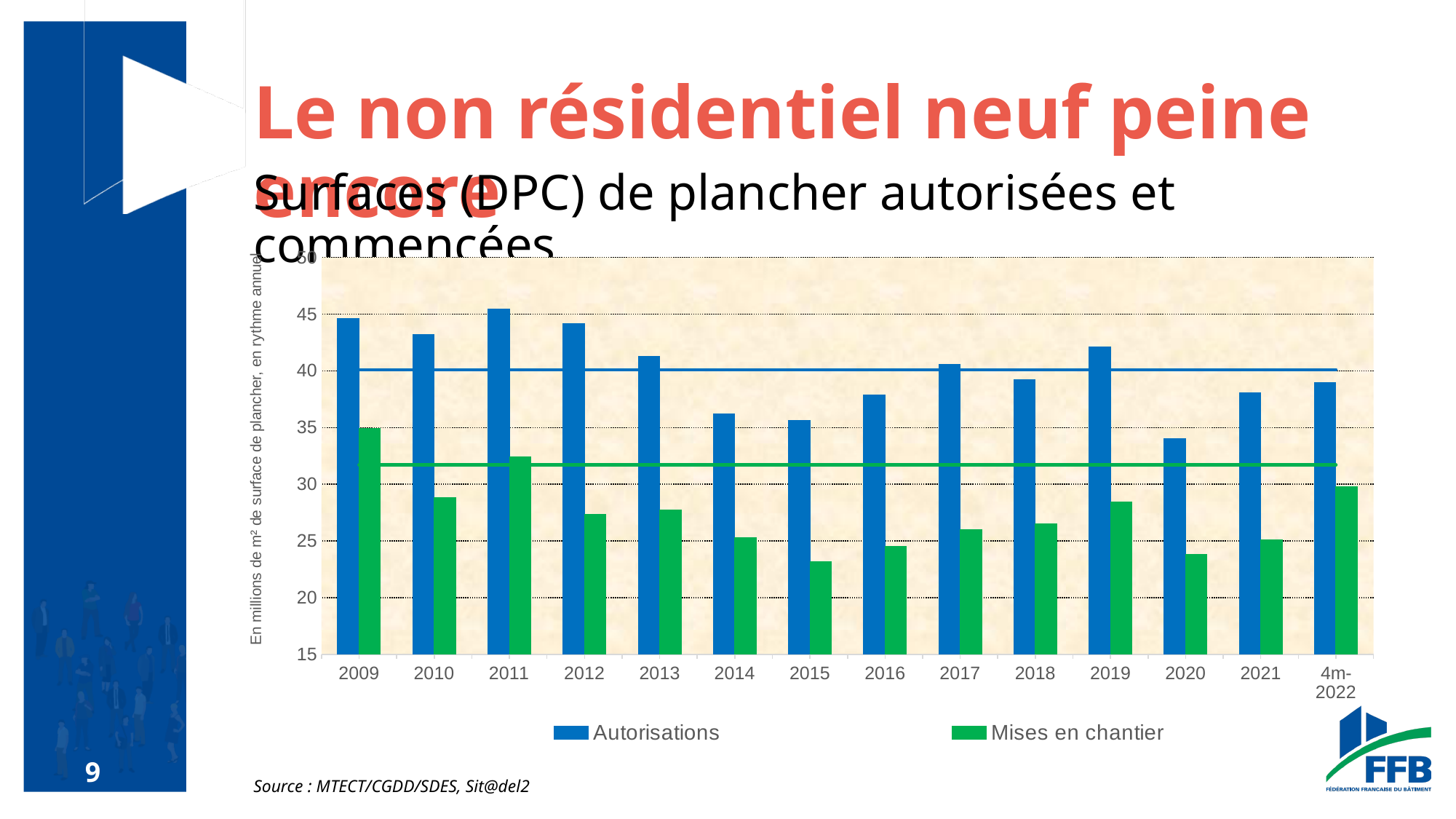
Is the value for Mises en chantier in 2015 greater or less than 25? less Which is larger, Autorisations in 2009 or Autorisations in 2010? 2009 Which colour represents Mises en chantier in the legend? green Which year has the lowest value for Autorisations? 2020 Which year has the highest value for Mises en chantier? 2009 Is the value for Autorisations in 2020 greater or less than 35? less Is the value for Autorisations in 2019 greater or less than 40? greater What kind of chart is shown on the slide? combination bar and line chart How many series does the legend list? 2 How many categories are shown on the x axis? 14 Do the values for Mises en chantier rise or fall from 2009 to 2015? fall